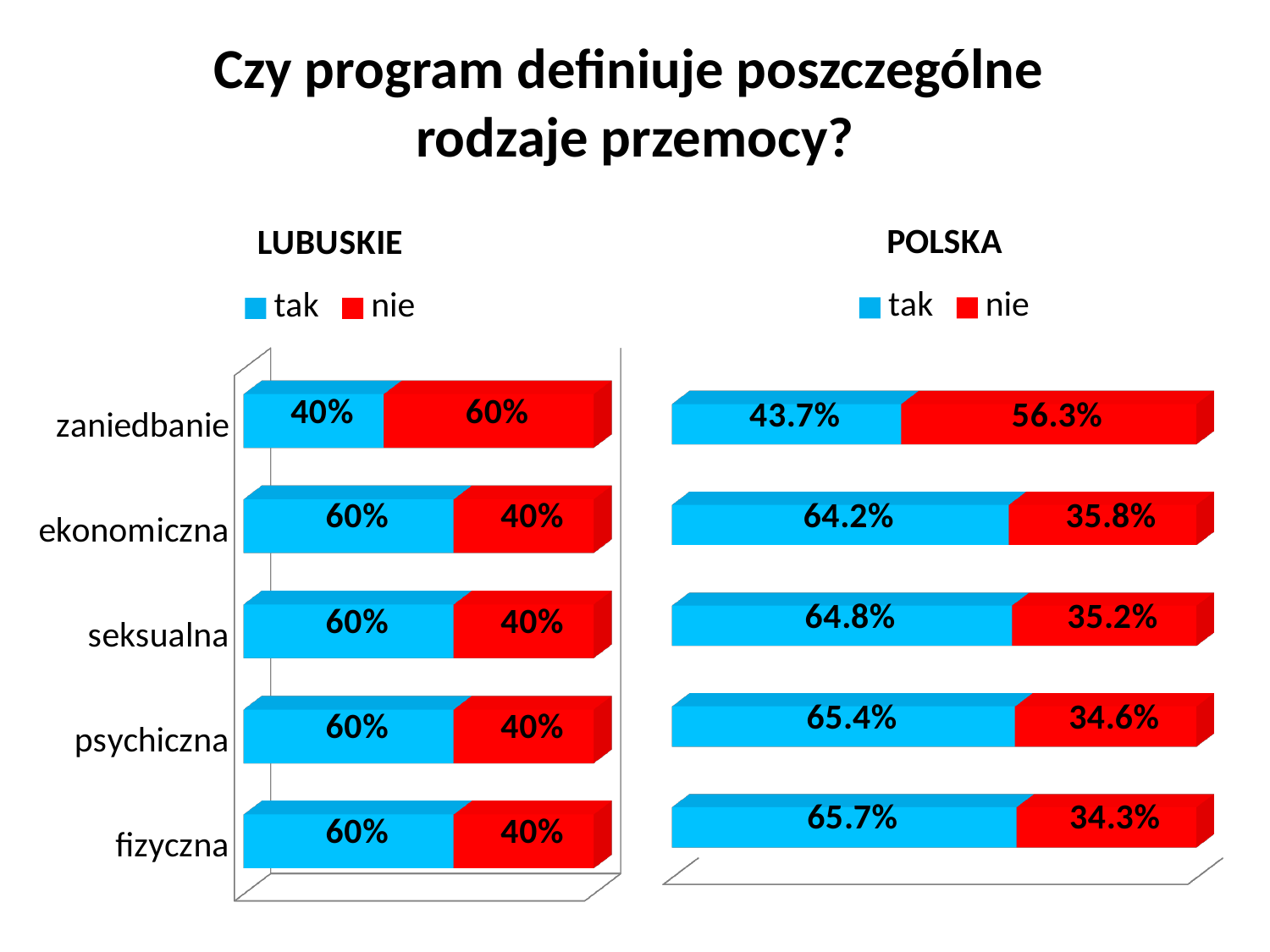
In the POLSKA chart, is the "tak" value for seksualna larger or smaller than the "nie" value for seksualna? larger In the POLSKA chart, which category has the highest "tak" value? fizyczna In the LUBUSKIE chart, what is the value of "tak" for zaniedbanie? 40% In the POLSKA chart, what is the value of "nie" for ekonomiczna? 35.8% In the POLSKA chart, which category has the lowest "tak" value? zaniedbanie What kind of chart is the LUBUSKIE chart? stacked bar chart In the POLSKA chart, what is the total of the stacked bar for zaniedbanie? 100% In the POLSKA chart, what is the difference between the "tak" values for psychiczna and zaniedbanie? 21.7% How many categories does the LUBUSKIE chart show? 5 How many series does the legend of the POLSKA chart list? 2 In the LUBUSKIE chart, which category has the highest "nie" value? zaniedbanie In the POLSKA chart, what is the value of "tak" for fizyczna? 65.7%